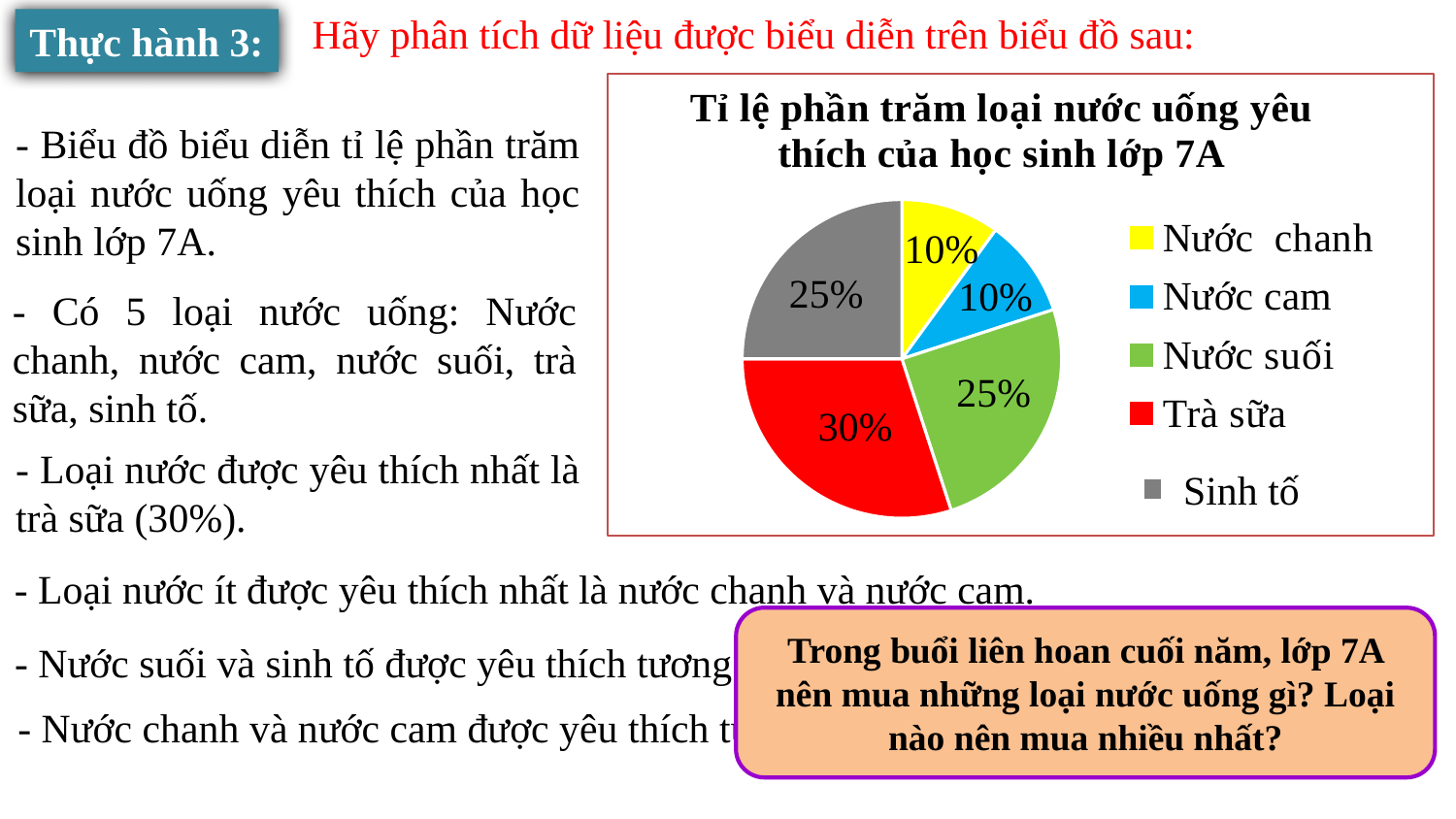
Which drink has the largest slice of the pie? Trà sữa What percentage of the pie does Nước chanh take? 10% What is the title of the chart? Tỉ lệ phần trăm loại nước uống yêu thích của học sinh lớp 7A What is the difference in percentage points between Trà sữa and Nước cam? 20% What colour is the Nước cam slice in the pie chart? blue How many entries does the legend list? 5 Which slice is larger, Trà sữa or Nước suối? Trà sữa How many slices does the pie chart have? 5 What percentage of the pie does Trà sữa take? 30% What percentage of the pie does Sinh tố take? 25% What percentage of the pie does Nước suối take? 25% What kind of chart is shown on the slide? pie chart